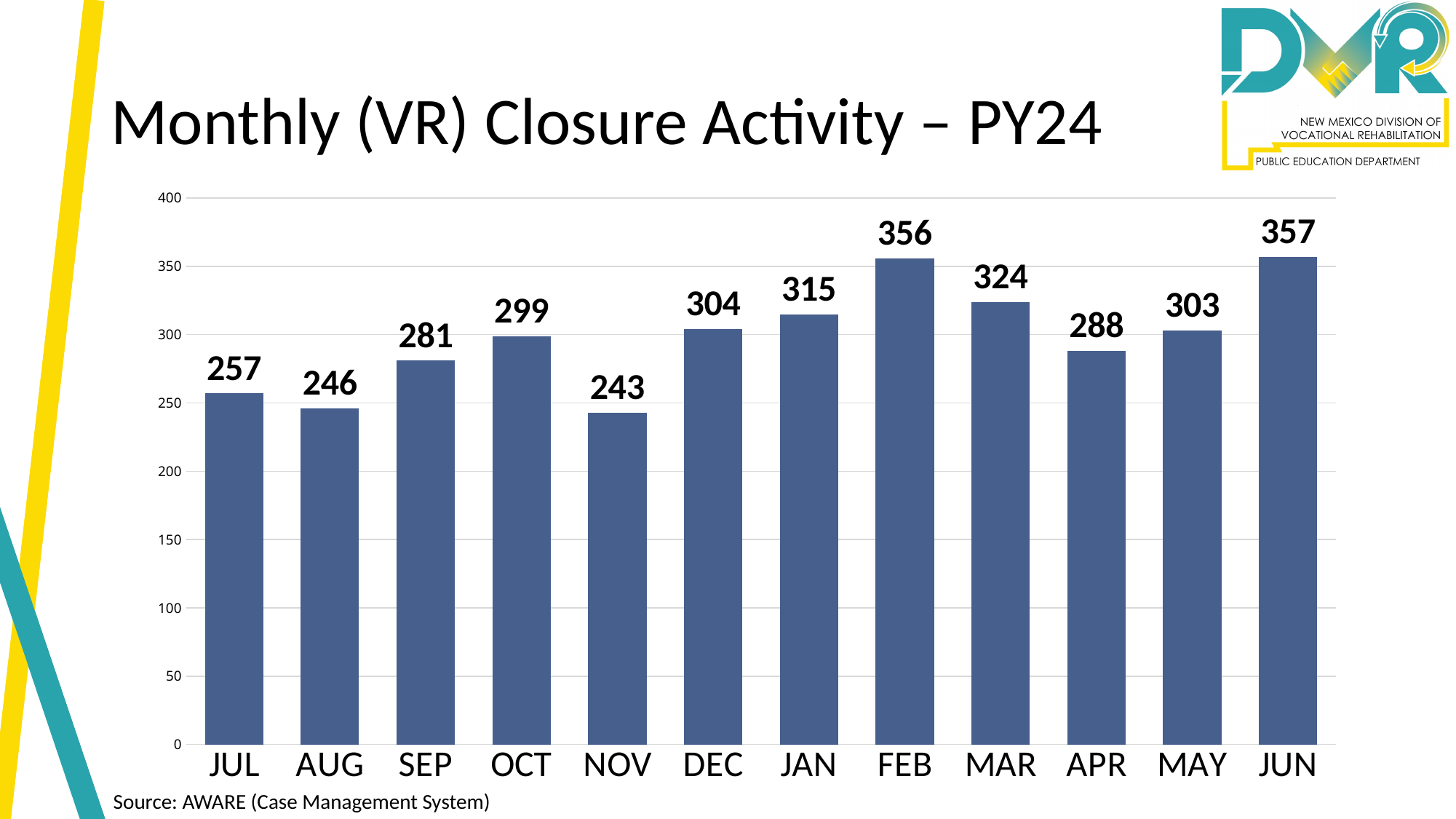
Which month has the lowest value? NOV What is the value for NOV? 243 How many months are shown on the x axis? 12 Which month has the highest value? JUN What is the difference between the values for JUN and JUL? 100 Which is larger, the value for DEC or the value for APR? DEC What is the difference between the values for FEB and MAR? 32 What is the value for MAR? 324 What is the title of the chart? Monthly (VR) Closure Activity – PY24 What kind of chart is shown on the slide? bar chart Is the value for OCT greater or less than 250? greater What is the value for FEB? 356